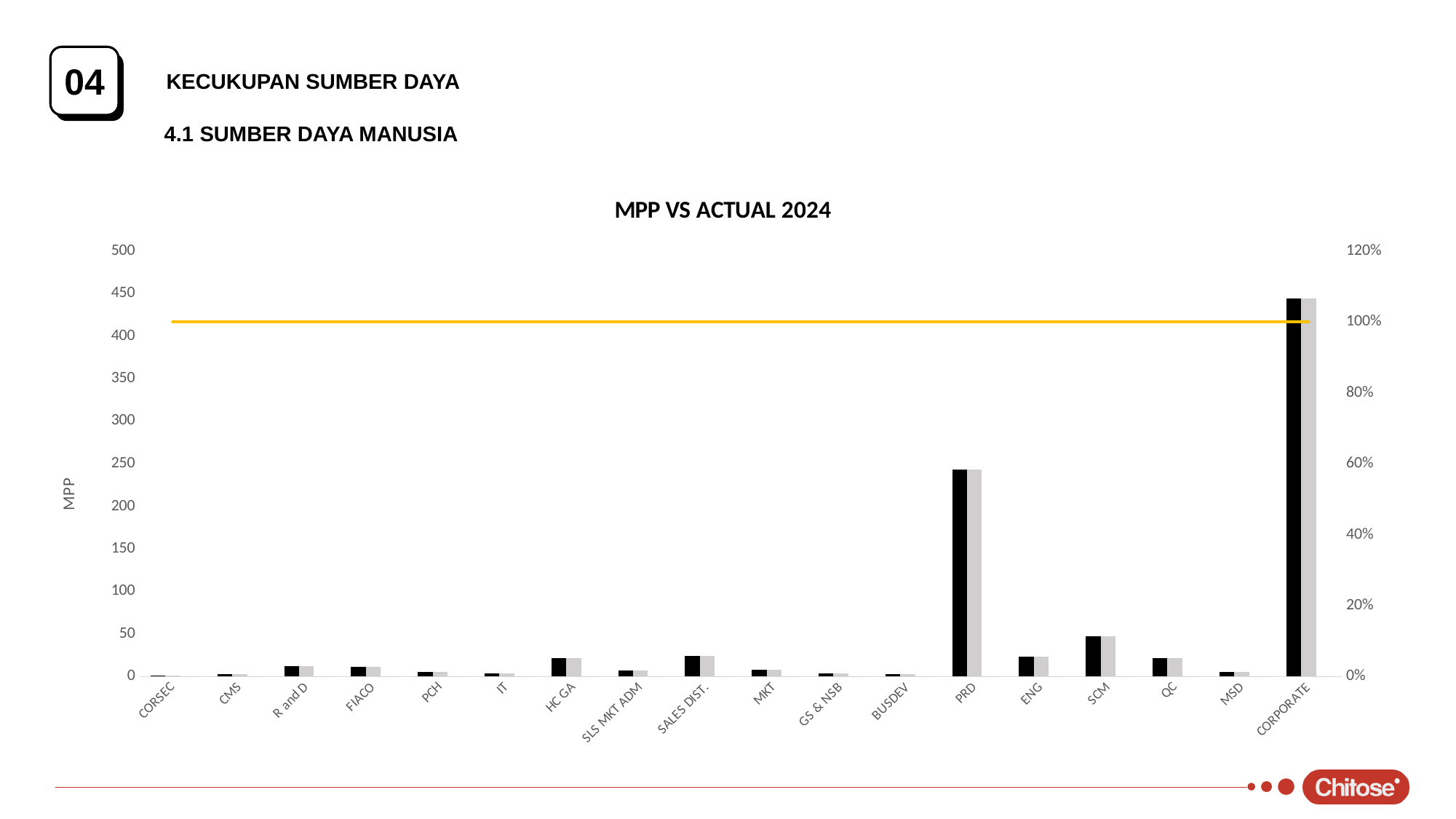
How many categories are shown on the x axis of the chart? 18 At what level on the right-hand axis is the horizontal yellow line drawn? 100% Which category has the highest bars in the chart? CORPORATE What kind of chart is shown on the slide? bar and line chart Is the value for PRD greater or less than 200? greater Which has a larger value, CORPORATE or PRD? CORPORATE Which has a larger value, PRD or ENG? PRD Is the value for CORPORATE greater or less than 400? greater Which has a larger value, SCM or QC? SCM What is the title of the chart? MPP VS ACTUAL 2024